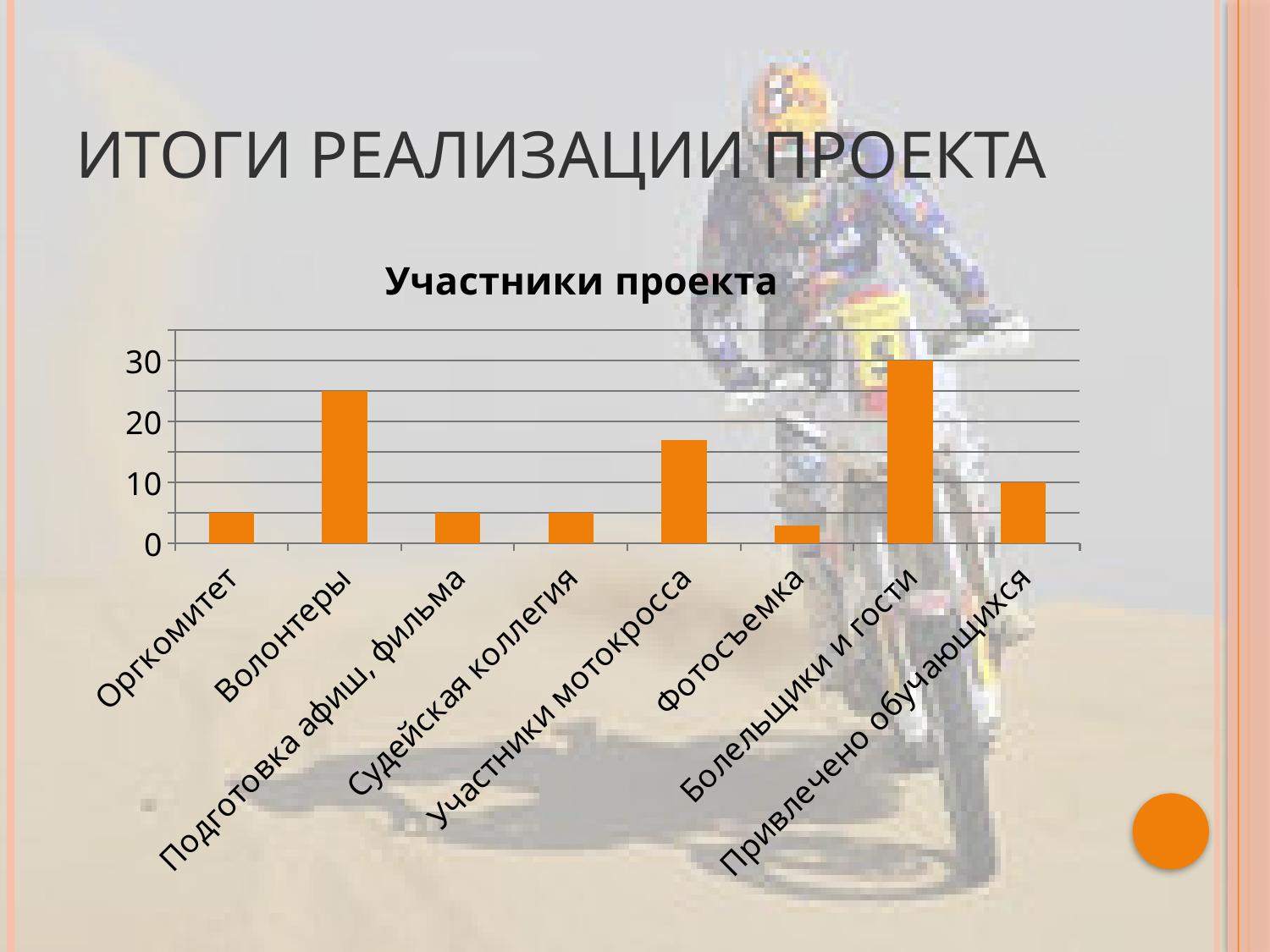
How many categories are shown on the x axis of the chart? 8 Which is larger, the value for Волонтеры or the value for Участники мотокросса? Волонтеры Is the value for Оргкомитет greater or less than 10? less Is the value for Волонтеры greater or less than 20? greater What is the difference between the values for Болельщики и гости and Привлечено обучающихся? 20 Which category has the lowest value in the chart? Фотосъемка What kind of chart is shown on the slide? bar chart Which category has the highest value in the chart? Болельщики и гости What is the title of the chart? Участники проекта What is the value for Привлечено обучающихся? 10 Is the value for Участники мотокросса greater or less than 20? less What is the value for Болельщики и гости? 30